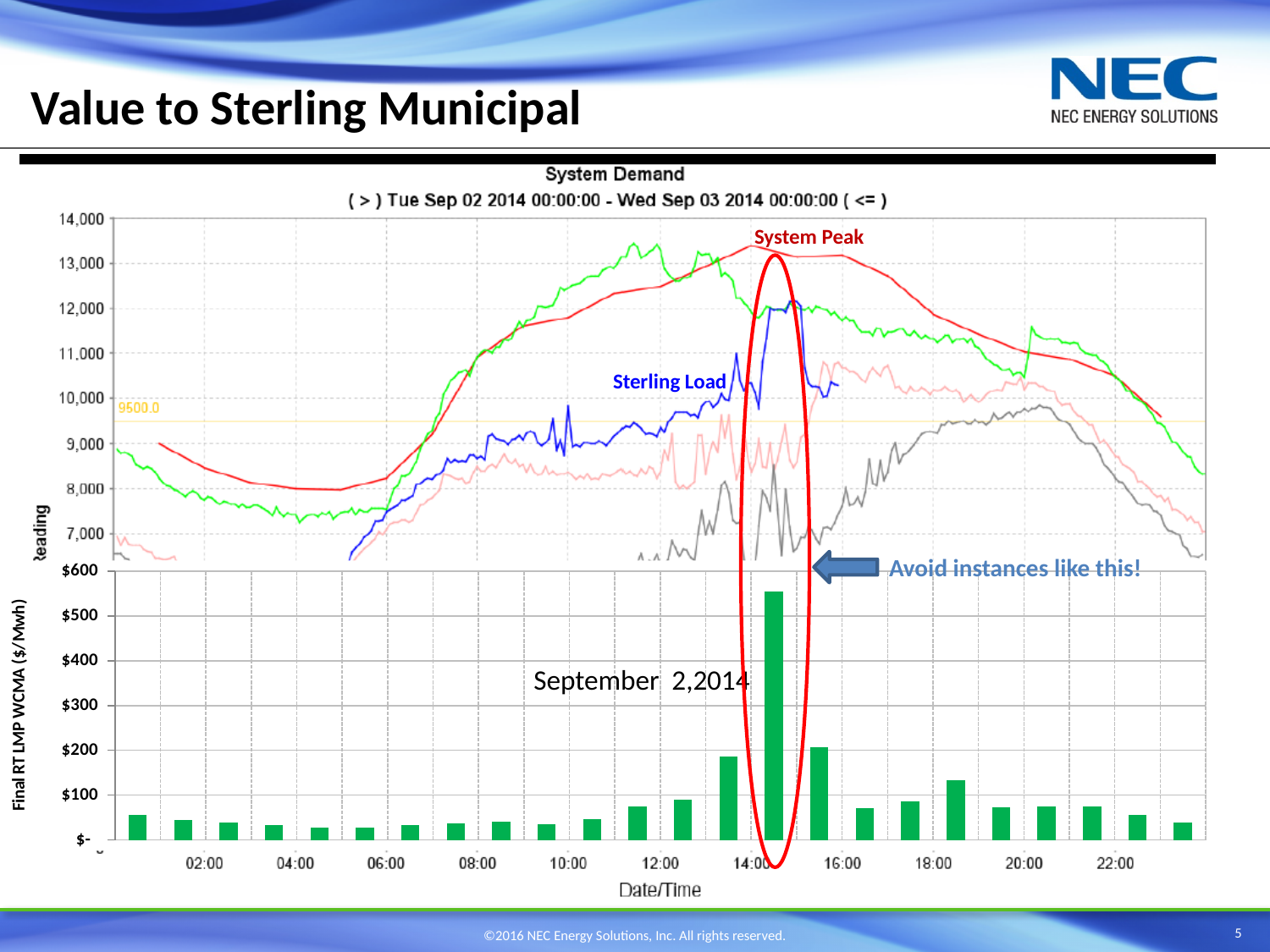
In the top chart, is the red System Peak line at 06:00 greater or less than 9,000? less In the bottom chart, is the value of the bar near 02:00 greater or less than $100? less In the bottom chart, is the value of the bar just after 18:00 greater or less than $100? greater In the bottom chart, do the bar values generally rise or fall from 06:00 to 14:00? rise What kind of chart is the top chart titled "System Demand"? line chart In the bottom chart, which bar is taller: the one just after 14:00 or the one just after 15:00? the one just after 14:00 In the top chart, does the red System Peak line rise or fall from 16:00 to 22:00? fall In the top chart, what value is labelled on the horizontal reference line? 9500.0 In the bottom chart, how many bars are plotted? 24 In the top chart, what date range is shown in the subtitle under "System Demand"? Tue Sep 02 2014 00:00:00 - Wed Sep 03 2014 00:00:00 What kind of chart is the bottom chart showing Final RT LMP WCMA ($/Mwh)? bar chart